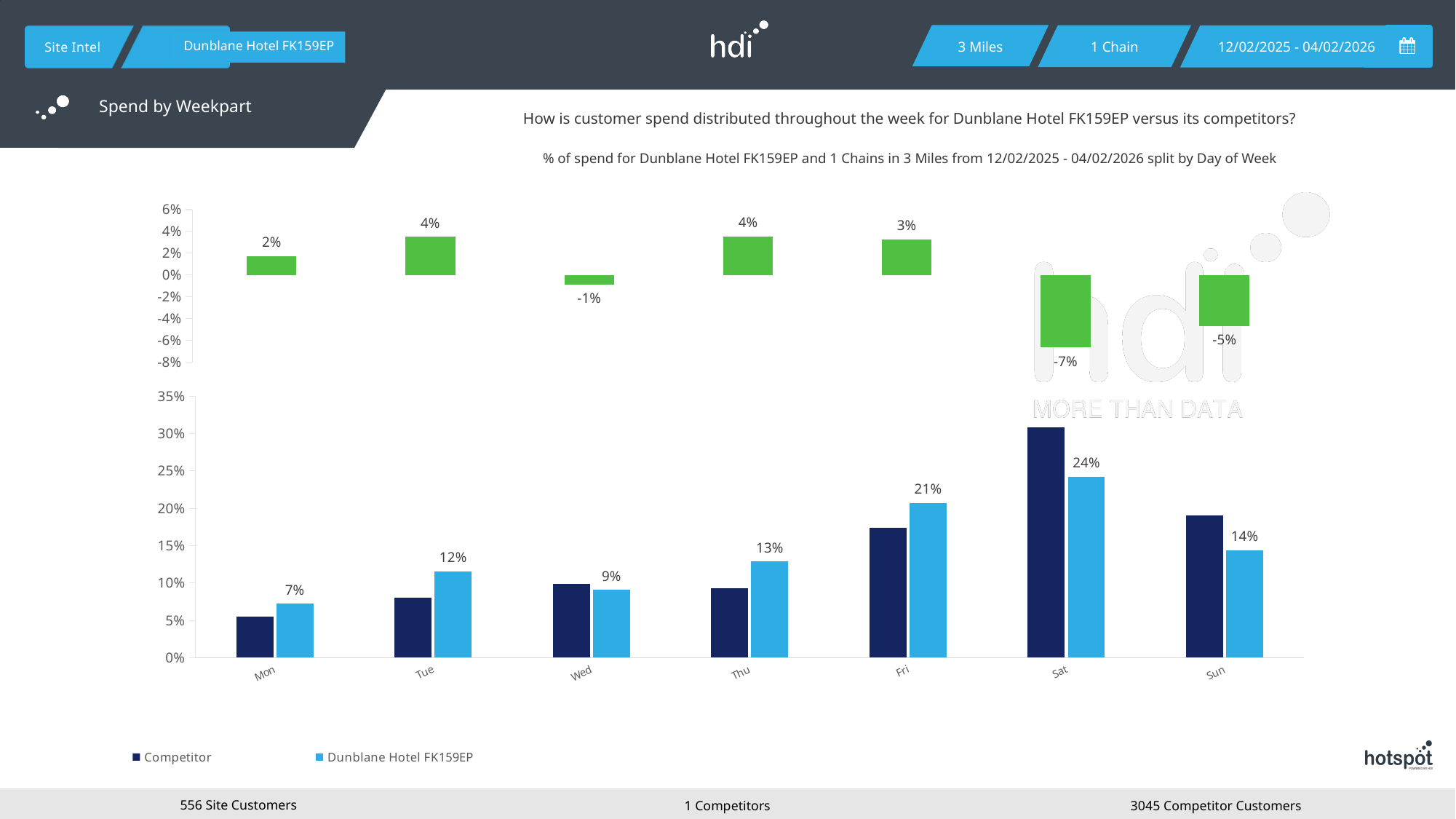
In the bottom chart, is the Competitor value for Sat greater or less than 25%? greater In the bottom chart, which day has the lowest value for Dunblane Hotel FK159EP? Mon In the bottom chart, what is the value for Dunblane Hotel FK159EP on Sat? 24% In the bottom chart, which day has the highest value for Dunblane Hotel FK159EP? Sat In the bottom chart, which is larger on Wed: the Competitor bar or the Dunblane Hotel FK159EP bar? Competitor What kind of chart is the bottom chart? bar chart How many days are shown on the x axis of the bottom chart? 7 How many series does the legend of the bottom chart list? 2 In the top chart, which day has the lowest value? Sat In the top chart, what is the value for Sat? -7% In the bottom chart, what is the difference between the Dunblane Hotel FK159EP values for Sat and Fri? 3% In the bottom chart, what is the value for Dunblane Hotel FK159EP on Tue? 12%